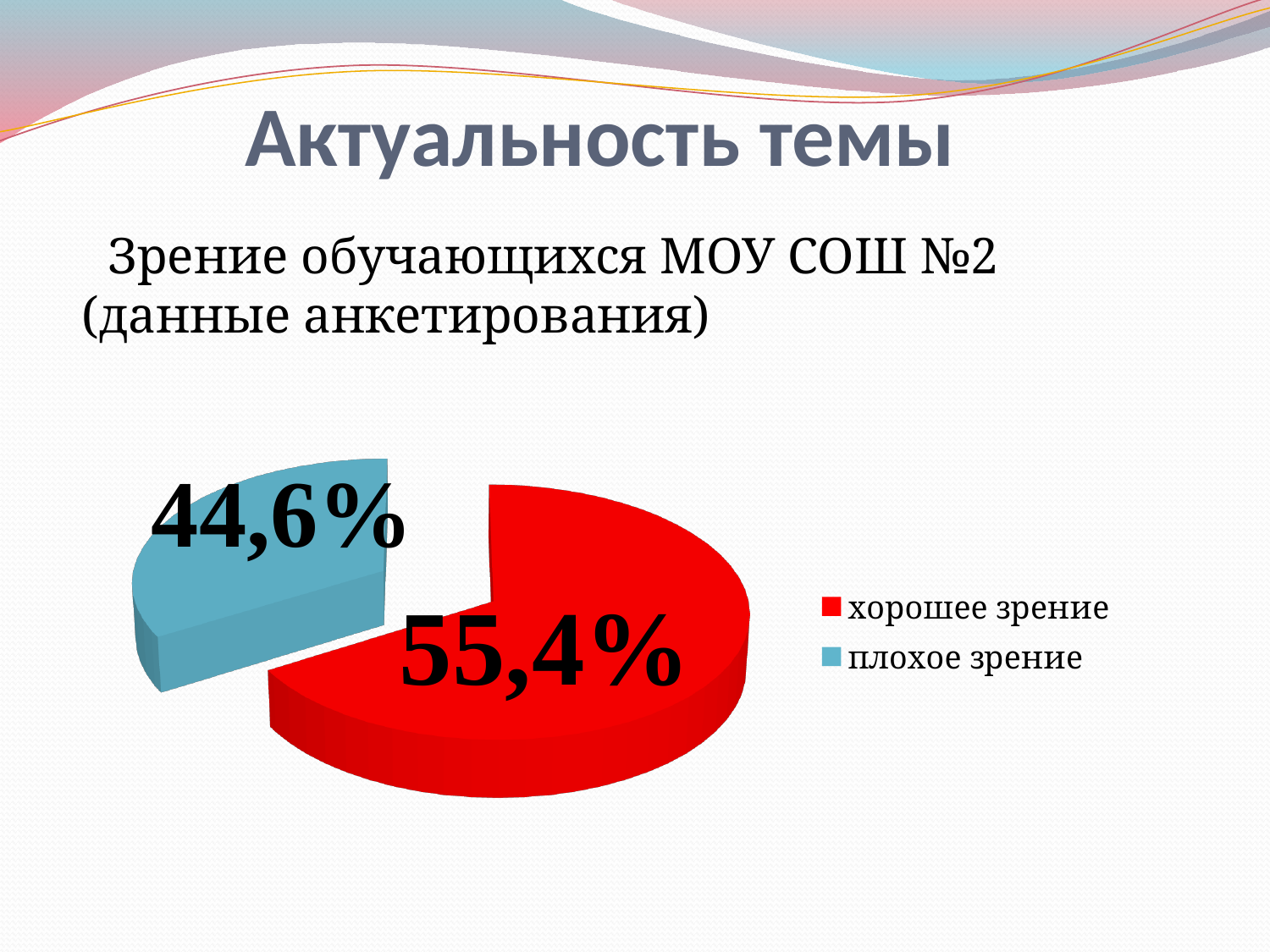
What colour is the slice for "хорошее зрение"? red Which is larger: the share for "хорошее зрение" or the share for "плохое зрение"? хорошее зрение How many slices does the pie chart have? 2 How many entries does the legend list? 2 What share of the pie is labelled "плохое зрение"? 44,6% What share of the pie is labelled "хорошее зрение"? 55,4% What is the difference between the shares for "хорошее зрение" and "плохое зрение"? 10,8% Which category has the largest slice of the pie? хорошее зрение What kind of chart is shown on the slide? pie chart Which category has the smallest slice of the pie? плохое зрение What colour is the slice for "плохое зрение"? blue